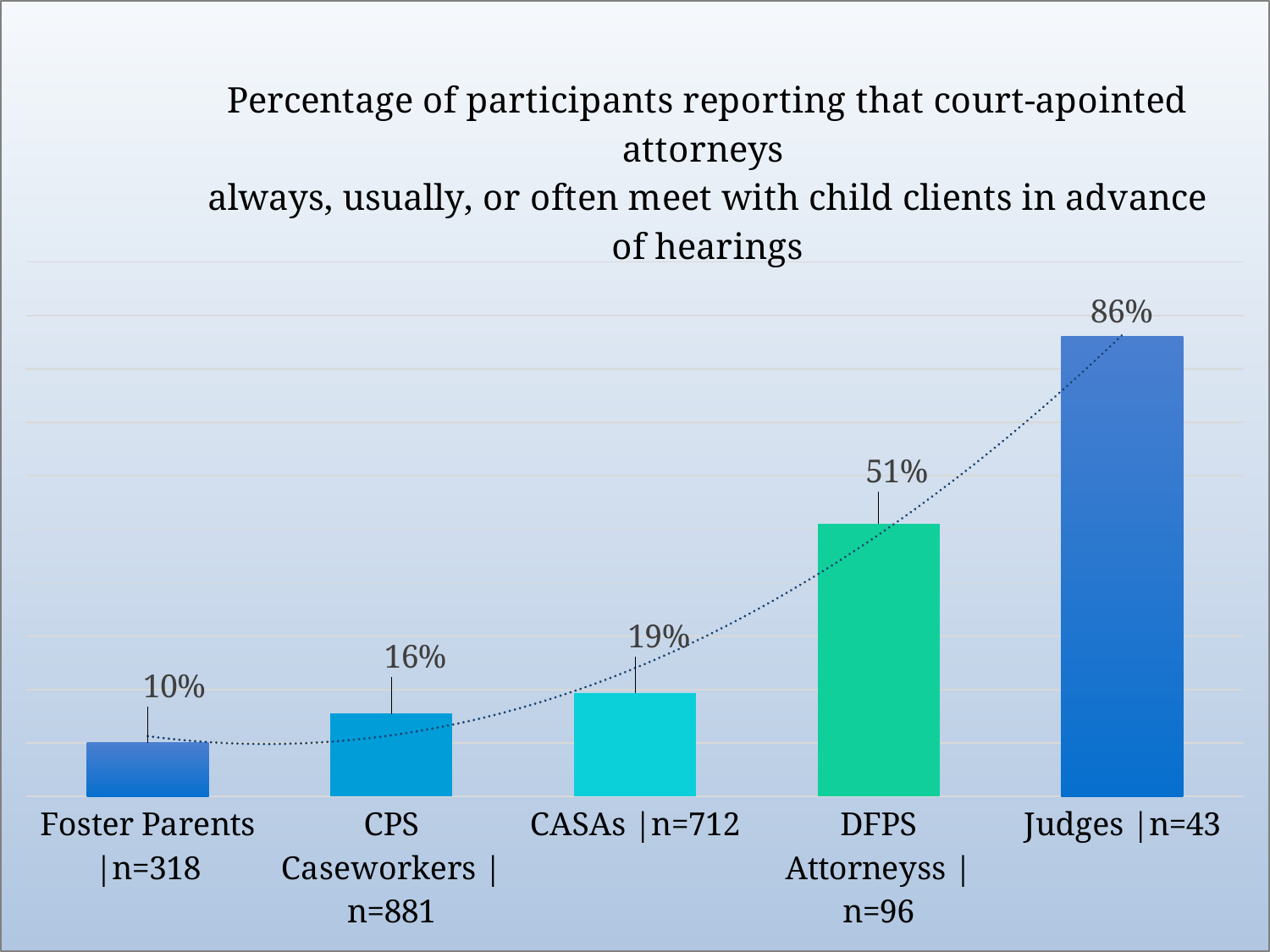
What percentage of Foster Parents reported that court-appointed attorneys always, usually, or often meet with child clients in advance of hearings? 10% Which participant group has the lowest percentage? Foster Parents What is the value shown for Judges? 86% What is the difference in percentage points between Judges and DFPS Attorneys? 35 What kind of chart is this? Bar chart What is the value shown for DFPS Attorneys? 51% What is the value shown for CASAs? 19% Which participant group has the highest percentage? Judges How many participant groups are shown in the chart? 5 What is the value shown for CPS Caseworkers? 16% Do the values rise or fall from left to right across the groups? Rise Which is larger, the value for CASAs or the value for CPS Caseworkers? CASAs